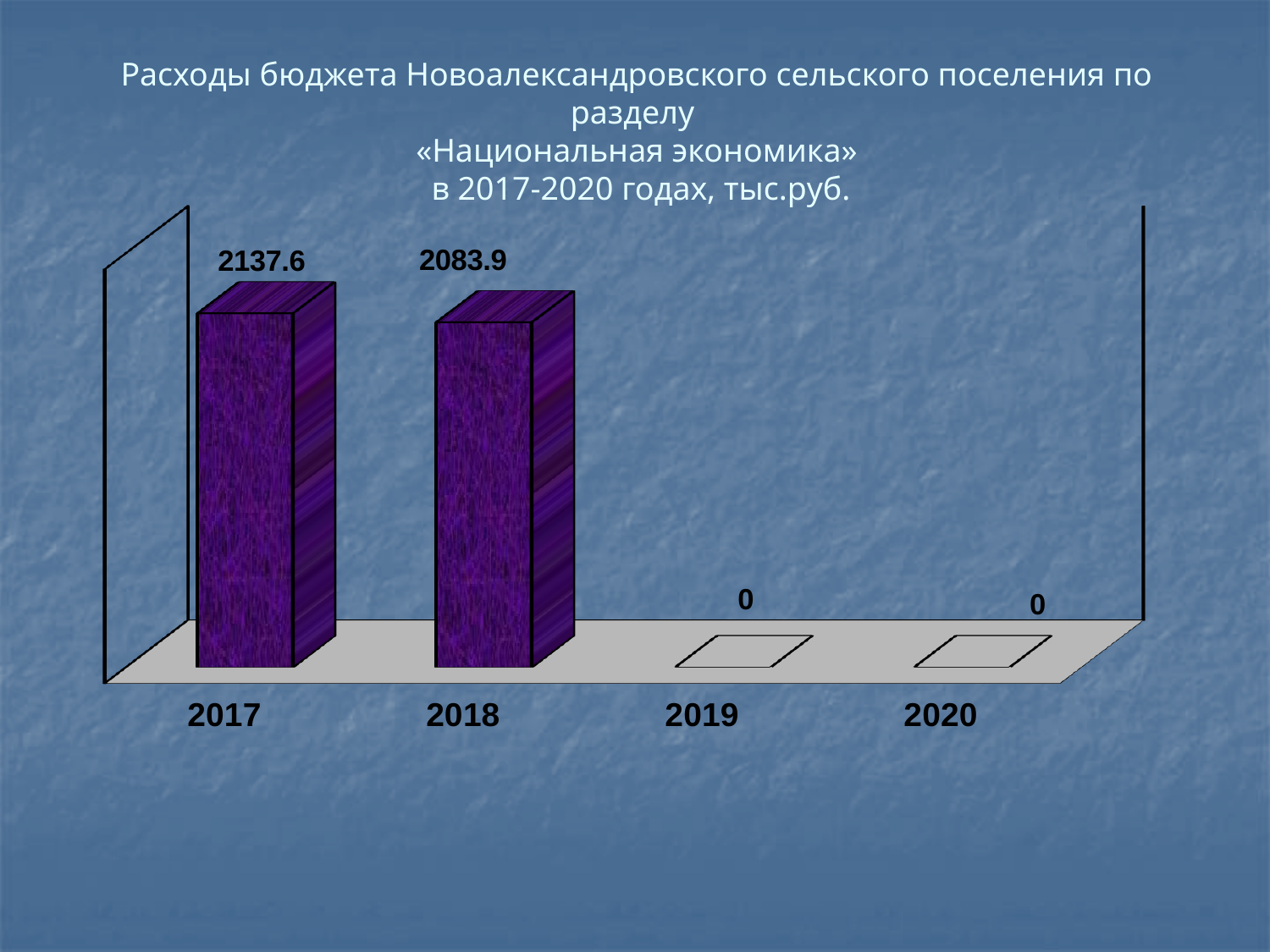
What is the value for 2019? 0 How many years are shown on the x axis? 4 What is the value for 2020? 0 Which year has the highest value? 2017 Which is larger, the value for 2017 or the value for 2018? 2017 In what units are the values in the chart expressed, according to the title? тыс.руб. What is the value for 2017? 2137.6 What is the value for 2018? 2083.9 What is the difference between the values for 2017 and 2018? 53.7 Do the values rise or fall from 2017 to 2020? fall What is the total of the values for 2017 and 2018? 4221.5 What kind of chart is shown on the slide? bar chart